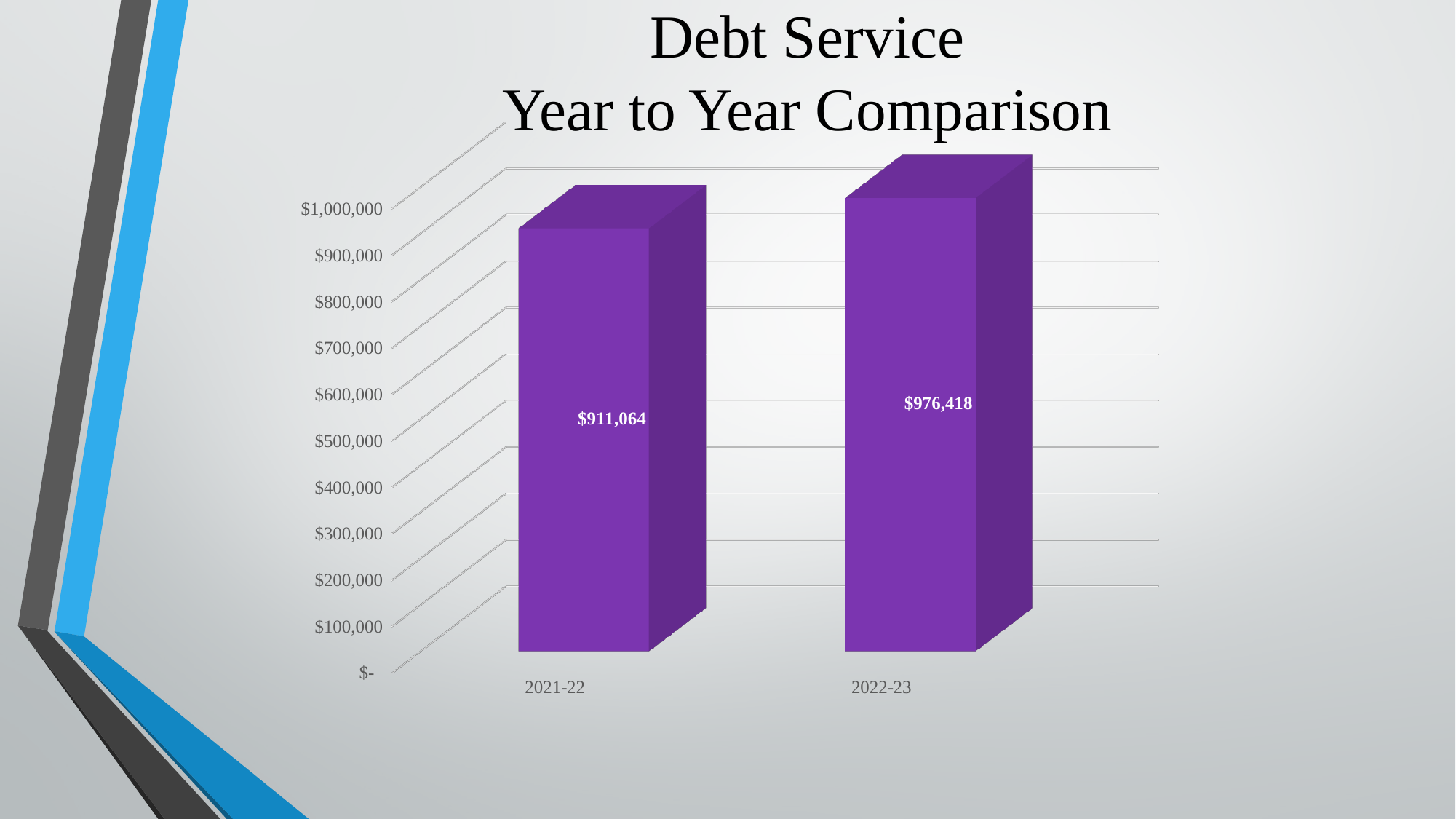
Is the value for 2021-22 greater or less than $1,000,000? less Is the value for 2022-23 greater or less than $900,000? greater Does the debt service rise or fall from 2021-22 to 2022-23? rise What kind of chart is shown on the slide? bar chart What is the difference in debt service between 2022-23 and 2021-22? $65,354 How many years are compared in the chart? 2 What is the debt service value for 2021-22? $911,064 Is the debt service for 2021-22 larger or smaller than for 2022-23? smaller Which year has the lower debt service? 2021-22 What is the debt service value for 2022-23? $976,418 What is the title of the chart? Debt Service Year to Year Comparison Which year has the higher debt service? 2022-23